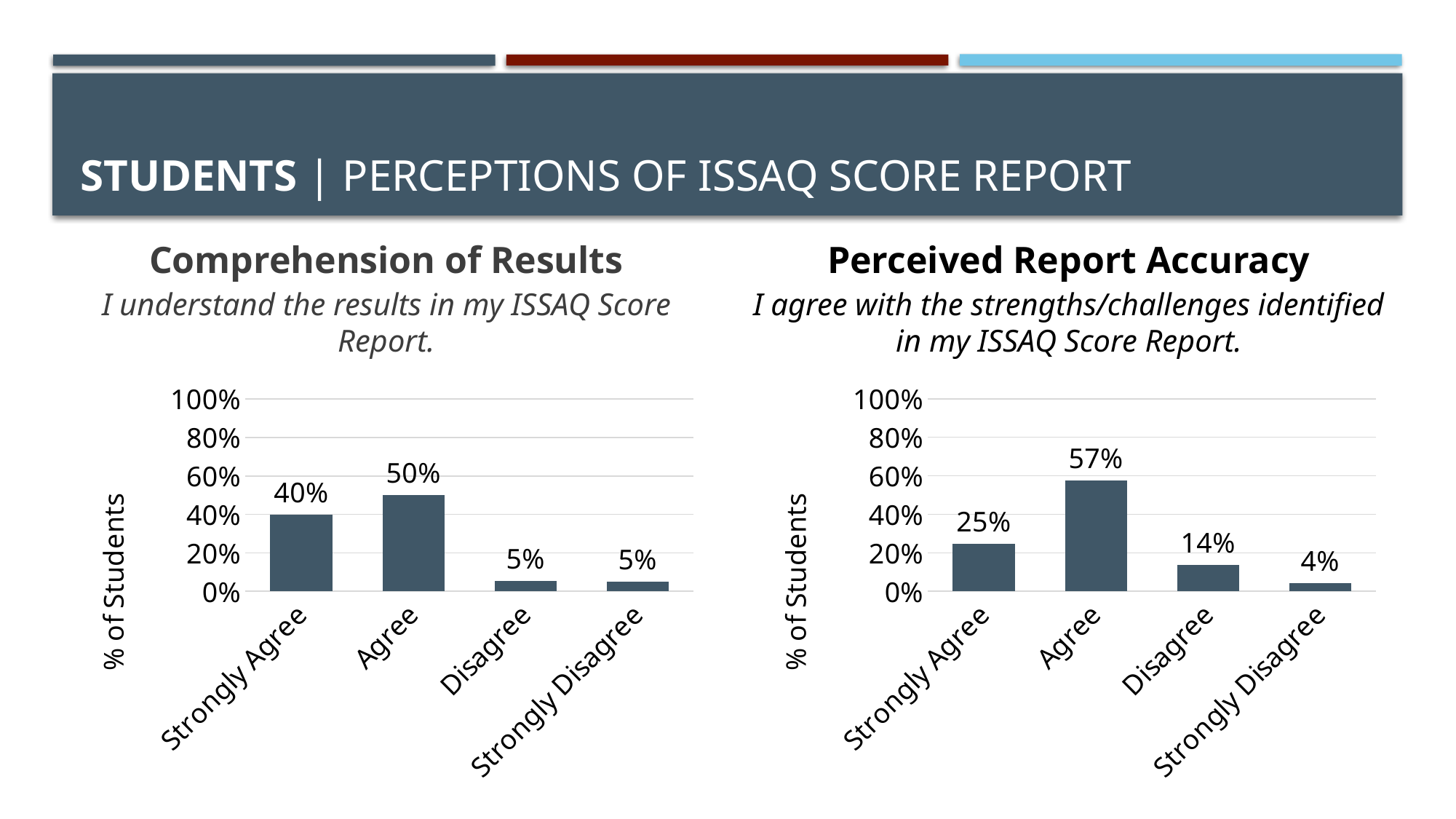
In the Perceived Report Accuracy chart, what percentage of students chose Disagree? 14% In the Comprehension of Results chart, what percentage of students chose Agree? 50% How many response categories are shown in the Perceived Report Accuracy chart? 4 In the Comprehension of Results chart, what is the combined value of Disagree and Strongly Disagree? 10% In the Perceived Report Accuracy chart, which response category has the highest value? Agree In the Comprehension of Results chart, is the value for Agree greater or less than 40%? greater In the Comprehension of Results chart, what is the difference between the Agree and Strongly Agree values? 10% What is the y-axis label on the Perceived Report Accuracy chart? % of Students Which chart has the larger value for Strongly Agree, Comprehension of Results or Perceived Report Accuracy? Comprehension of Results In the Perceived Report Accuracy chart, what is the difference between the Agree and Strongly Agree values? 32% In the Perceived Report Accuracy chart, which response category has the lowest value? Strongly Disagree What kind of chart is the Comprehension of Results chart? Bar chart